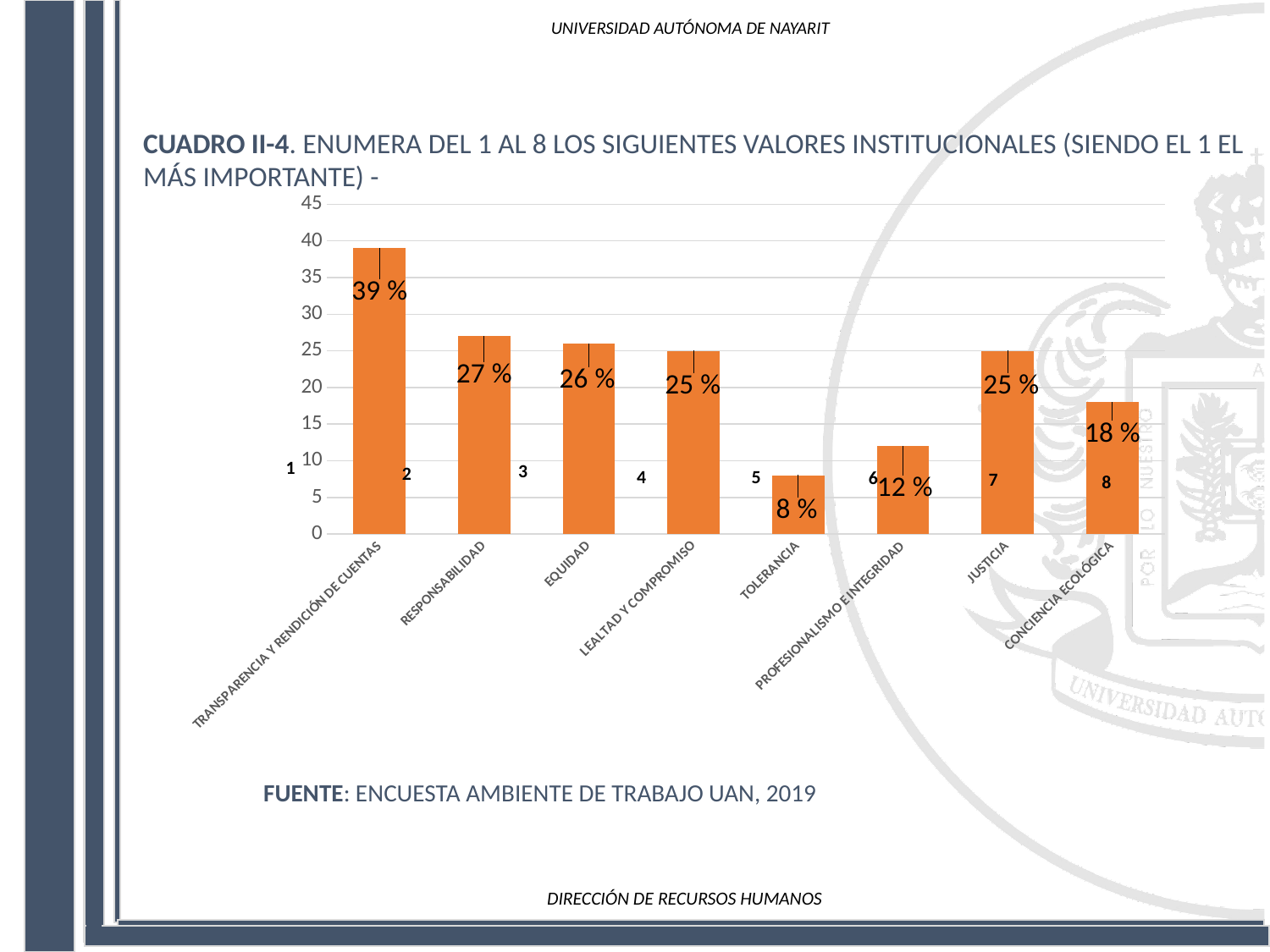
What value is shown for CONCIENCIA ECOLÓGICA? 18 % What value is shown for TOLERANCIA? 8 % What kind of chart is shown on the slide? bar chart Is the value for LEALTAD Y COMPROMISO greater or less than 30? less How many categories are shown on the x axis? 8 Which category has the lowest value? TOLERANCIA What value is shown for TRANSPARENCIA Y RENDICIÓN DE CUENTAS? 39 % What is the difference between the values for RESPONSABILIDAD and EQUIDAD? 1 % Which category has the highest value? TRANSPARENCIA Y RENDICIÓN DE CUENTAS What is the source cited below the chart? ENCUESTA AMBIENTE DE TRABAJO UAN, 2019 Which is larger, the value for JUSTICIA or the value for CONCIENCIA ECOLÓGICA? JUSTICIA What value is shown for PROFESIONALISMO E INTEGRIDAD? 12 %